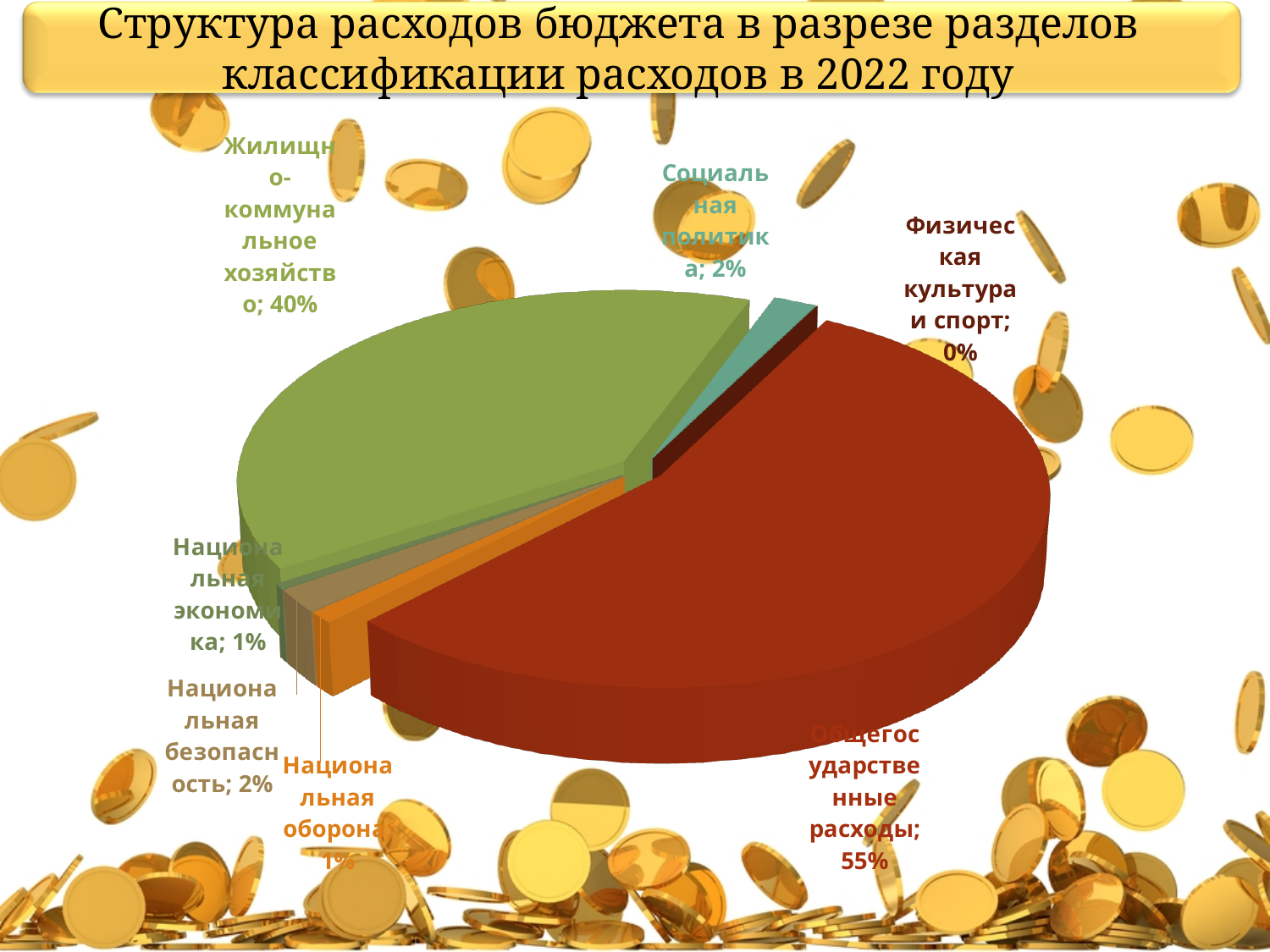
What share is labelled for Национальная оборона? 1% What kind of chart is shown on the slide? Pie chart Which section has the largest share of budget expenditure? Общегосударственные расходы What is the difference in percentage points between Общегосударственные расходы and Жилищно-коммунальное хозяйство? 15 percentage points What share is labelled for Жилищно-коммунальное хозяйство? 40% Which section has the smallest share of budget expenditure? Физическая культура и спорт Which is larger: the share for Национальная безопасность or the share for Национальная экономика? Национальная безопасность How many sections of expenditure are shown in the pie chart? 7 What share is labelled for Физическая культура и спорт? 0% What share of budget expenditure is labelled for Общегосударственные расходы? 55% Which year does the chart title say the budget expenditure structure refers to? 2022 What share is labelled for Социальная политика? 2%